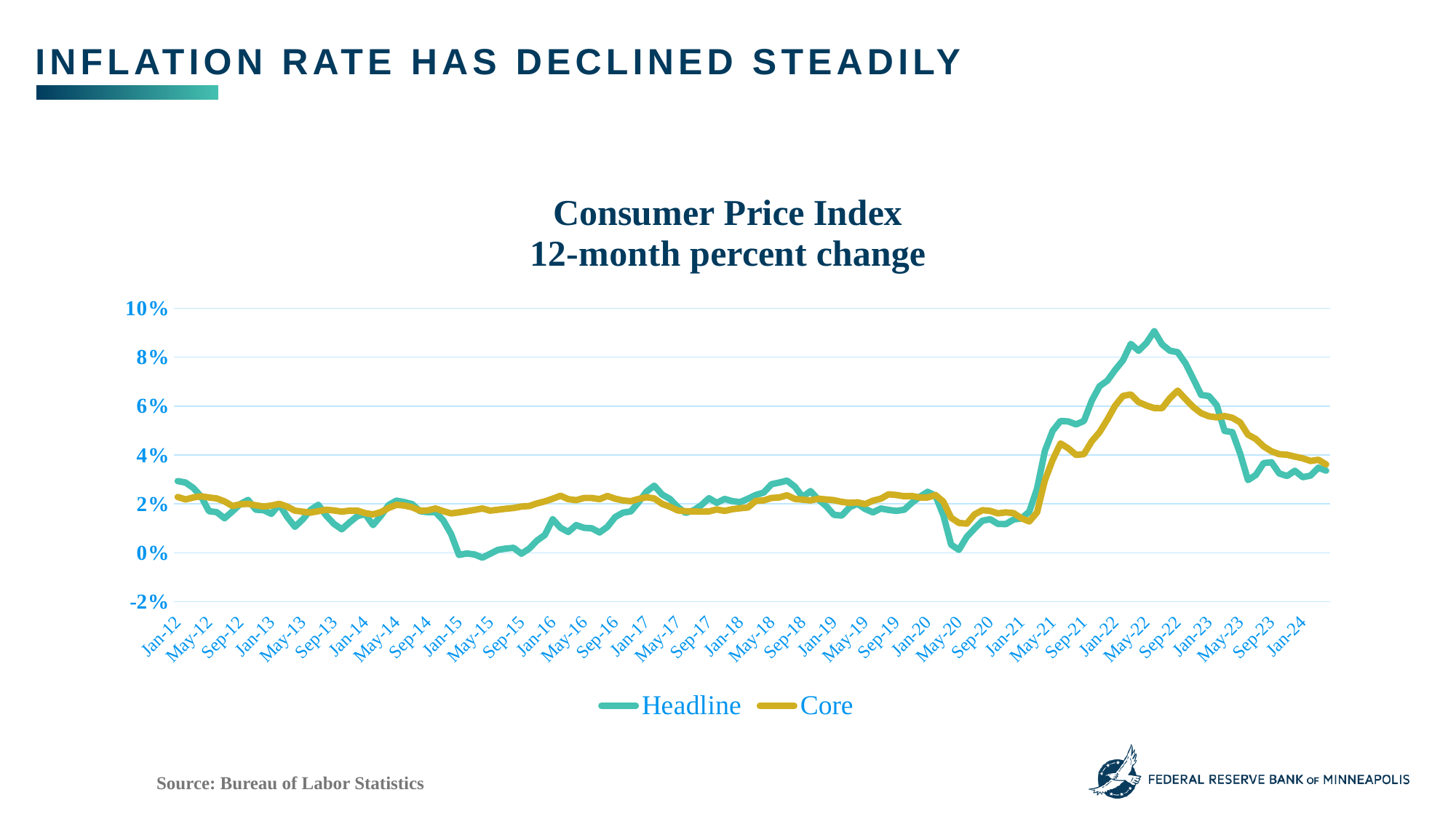
Is the peak value of the Core series in 2022 greater or less than 6%? greater What kind of chart is shown on the slide? line chart Which series reaches the highest value on the chart? Headline Does the Headline series rise or fall between its mid-2022 peak and Jan-24? fall Is the value for Headline at May-20 greater or less than 2%? less Which series reaches the lowest value on the chart? Headline Which series is drawn in the gold/yellow line? Core At the 2022 peak, which series is higher, Headline or Core? Headline How many series does the legend list? 2 What is the title of the chart? Consumer Price Index 12-month percent change Is the peak value of the Headline series in 2022 greater or less than 8%? greater At May-20, which series is higher, Headline or Core? Core